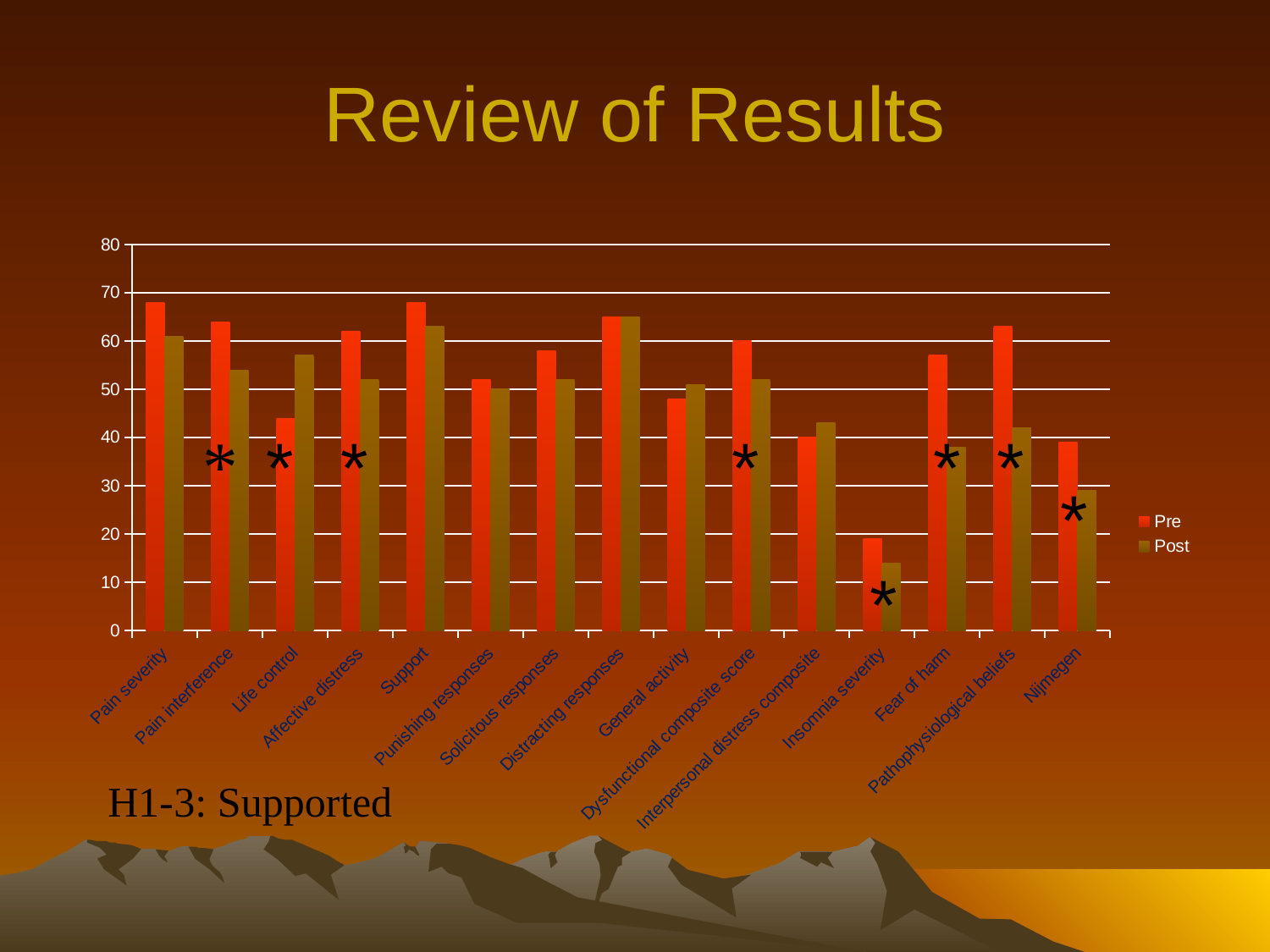
Is the Post value for Insomnia severity greater or less than 20? less Is the Post value for Interpersonal distress composite greater or less than 50? less How many categories are shown on the x axis? 15 What are the two series named in the legend? Pre and Post For Life control, which is larger, the Pre value or the Post value? Post For Pain severity, which is larger, the Pre value or the Post value? Pre Which category has the lowest Post value? Insomnia severity Is the Pre value for Pain severity greater or less than 60? greater How many series does the legend list? 2 Which category has the lowest Pre value? Insomnia severity What kind of chart is shown on the slide? bar chart